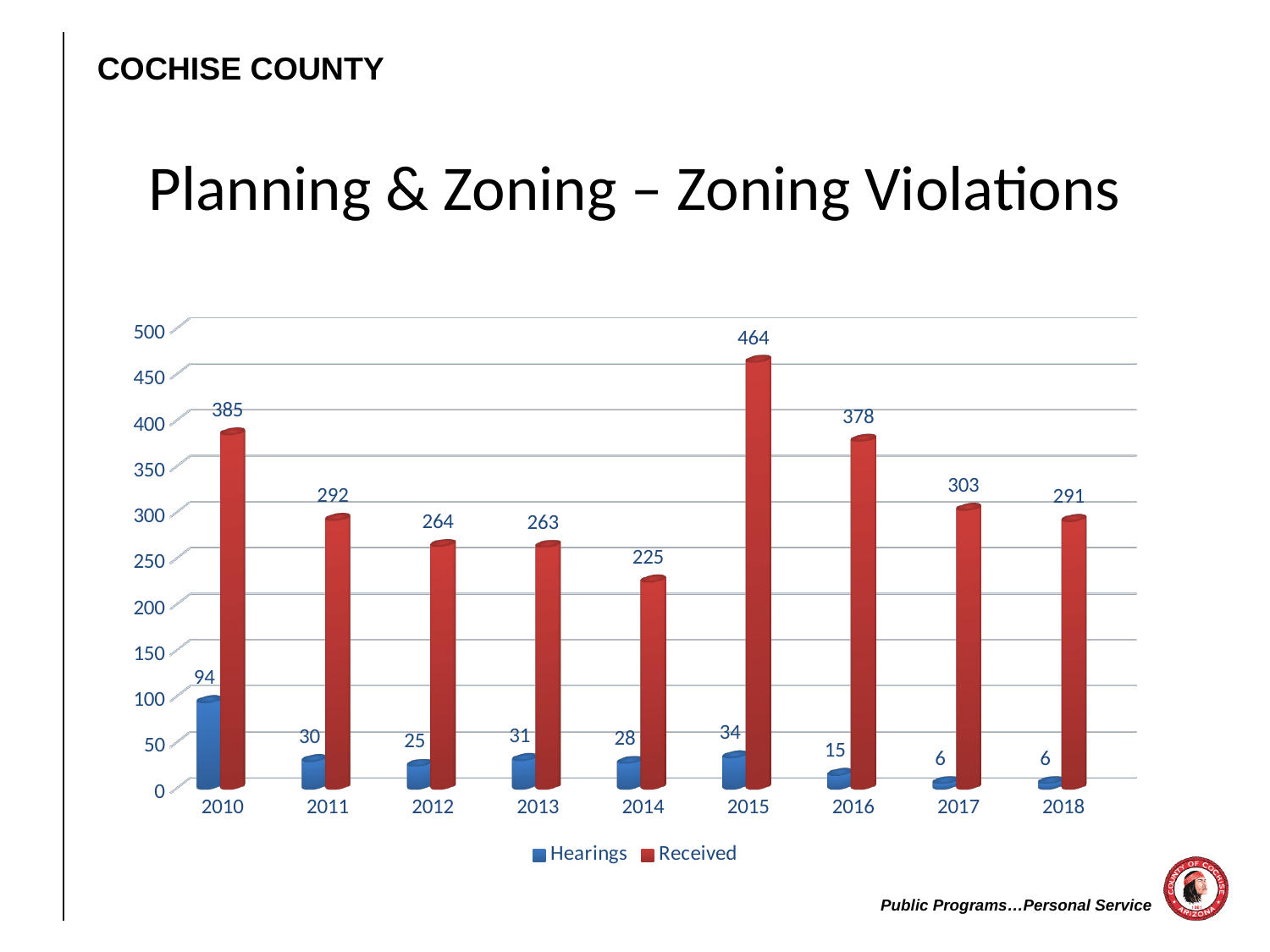
Which year had the lowest number of violations received? 2014 Which colour represents the Received series in the chart? Red Which year had more hearings, 2013 or 2016? 2013 How many series does the legend list? 2 What kind of chart is shown on the slide? Bar chart What was the number of zoning violations received in 2015? 464 Is the number of violations received in 2010 greater or less than 350? greater Did the number of hearings rise or fall from 2015 to 2018? Fall How many years are shown on the x axis? 9 What is the difference between violations received in 2015 and 2016? 86 How many hearings were held in 2010? 94 Which year had the highest number of violations received? 2015